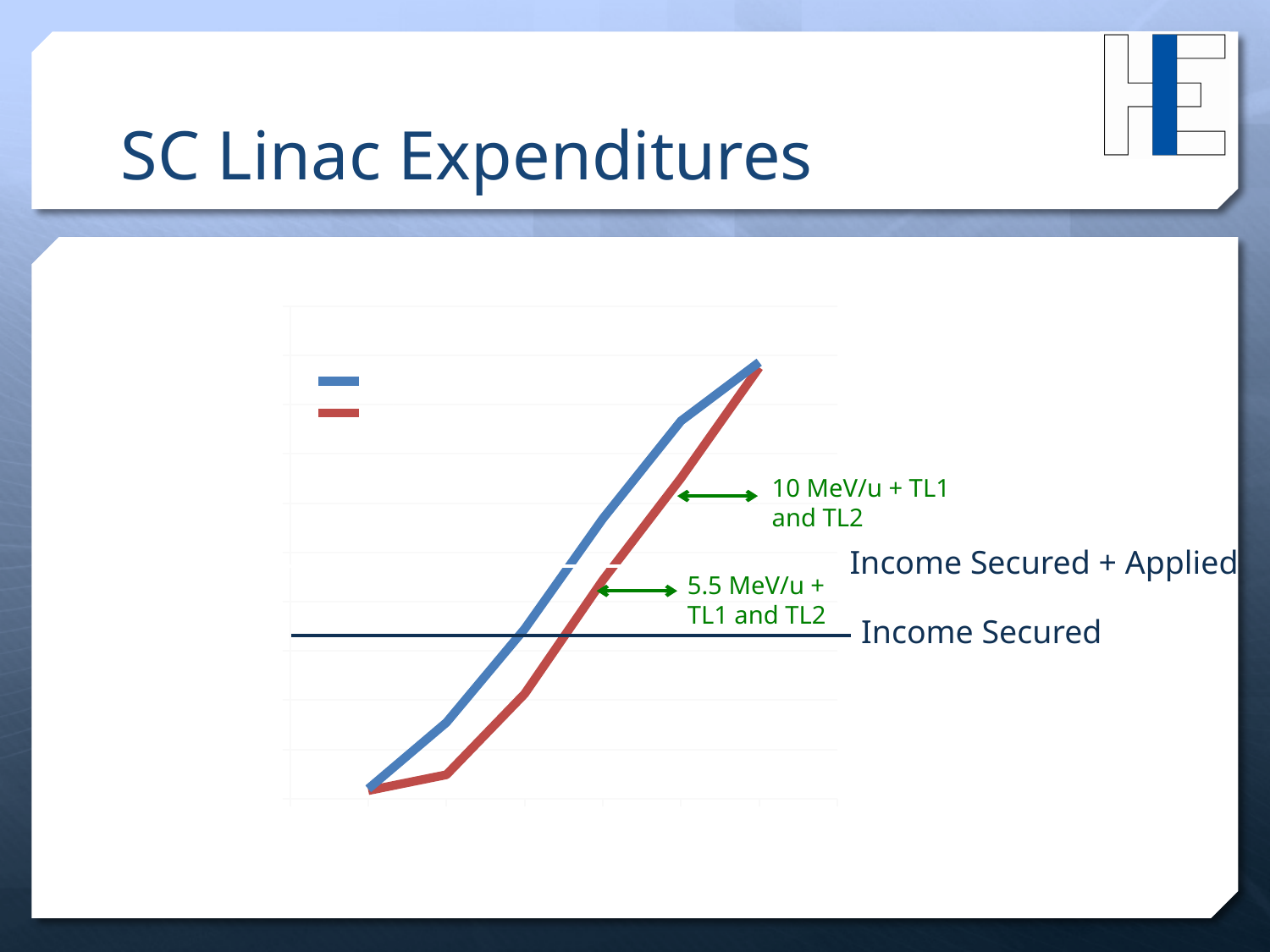
How many series does the legend list? 2 What kind of chart is shown on the slide? line chart Do the values of the red line rise or fall from left to right? rise Do the values of the blue line rise or fall from left to right? rise In the middle of the chart, which line is higher, the blue line or the red line? the blue line What label is attached to the horizontal dark line drawn across the chart? Income Secured What colours are the two plotted lines? blue and red